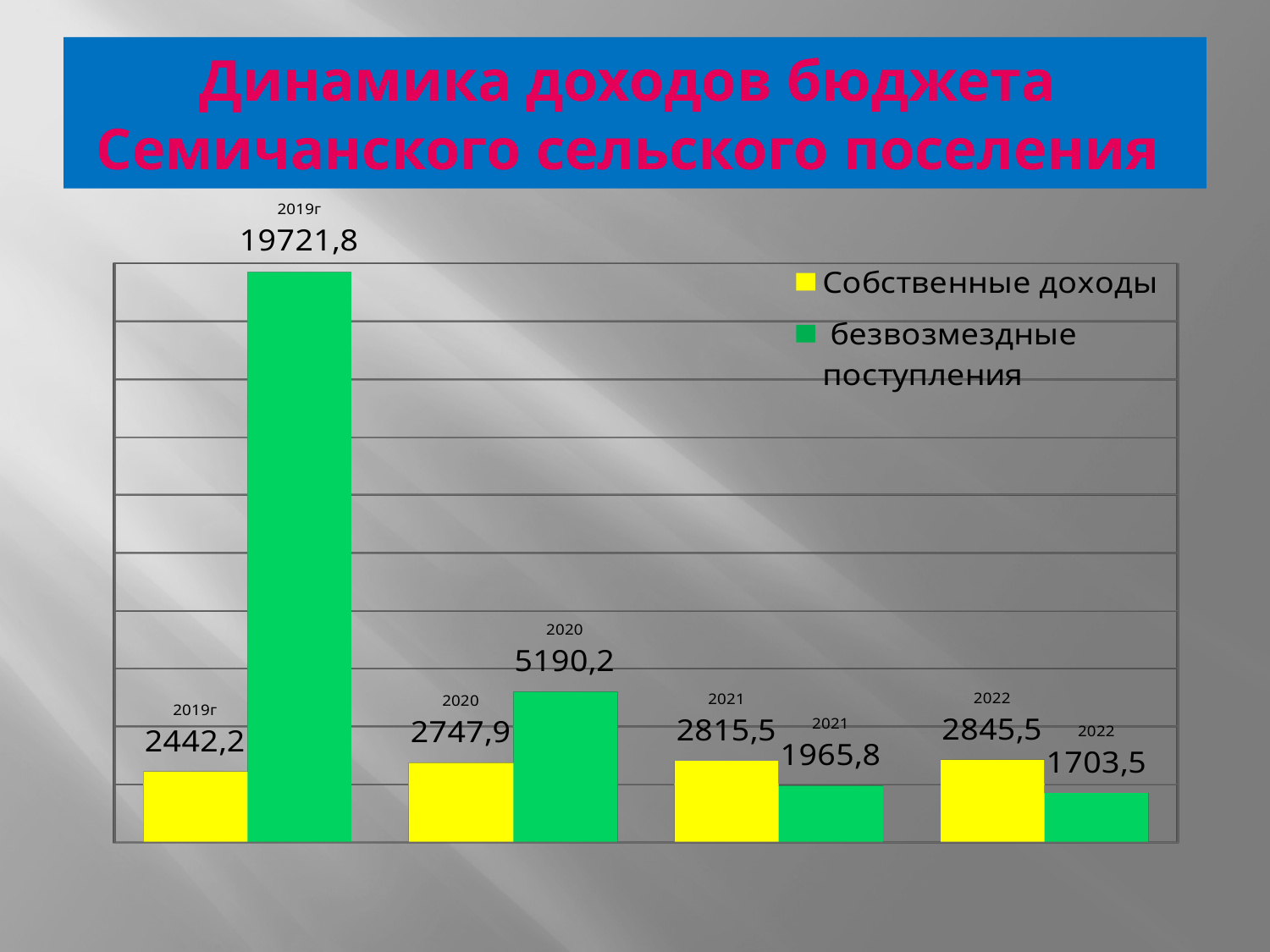
What is the difference between безвозмездные поступления in 2019г and in 2020? 14531,6 What is the value of Собственные доходы for 2019г? 2442,2 In which year is безвозмездные поступления lowest? 2022 In which year is безвозмездные поступления highest? 2019г What is the value of безвозмездные поступления for 2020? 5190,2 How many series does the legend list? 2 Which is larger in 2021: Собственные доходы or безвозмездные поступления? Собственные доходы What kind of chart is shown on the slide? Bar chart What is the value of Собственные доходы for 2022? 2845,5 In which year is Собственные доходы lowest? 2019г How many years are shown on the chart? 4 What is the value of безвозмездные поступления for 2019г? 19721,8